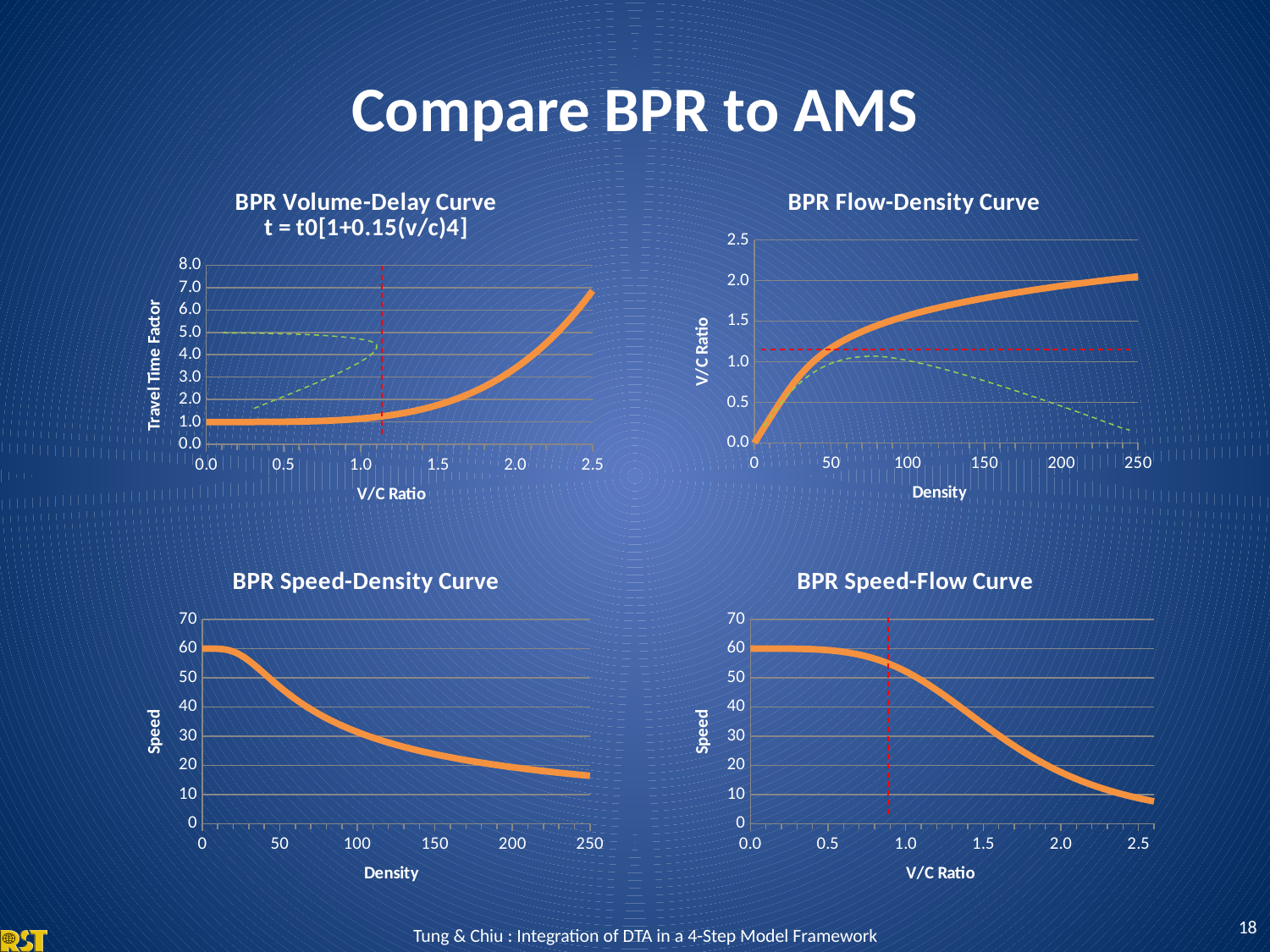
In the BPR Volume-Delay Curve, does the orange line rise or fall as the V/C Ratio increases? rise What is the x-axis label of the BPR Speed-Density Curve? Density In the BPR Speed-Density Curve, is the Speed at Density 0 greater or less than 50? greater How many charts are shown on the slide? 4 In the BPR Speed-Density Curve, does the orange line rise or fall as Density increases? fall What kind of chart is the BPR Volume-Delay Curve? line chart In the BPR Flow-Density Curve, does the orange line rise or fall as Density increases? rise In the BPR Speed-Density Curve, is the Speed at Density 250 greater or less than 20? less In the BPR Volume-Delay Curve, is the Travel Time Factor of the orange line at V/C Ratio 2.5 greater or less than 5.0? greater